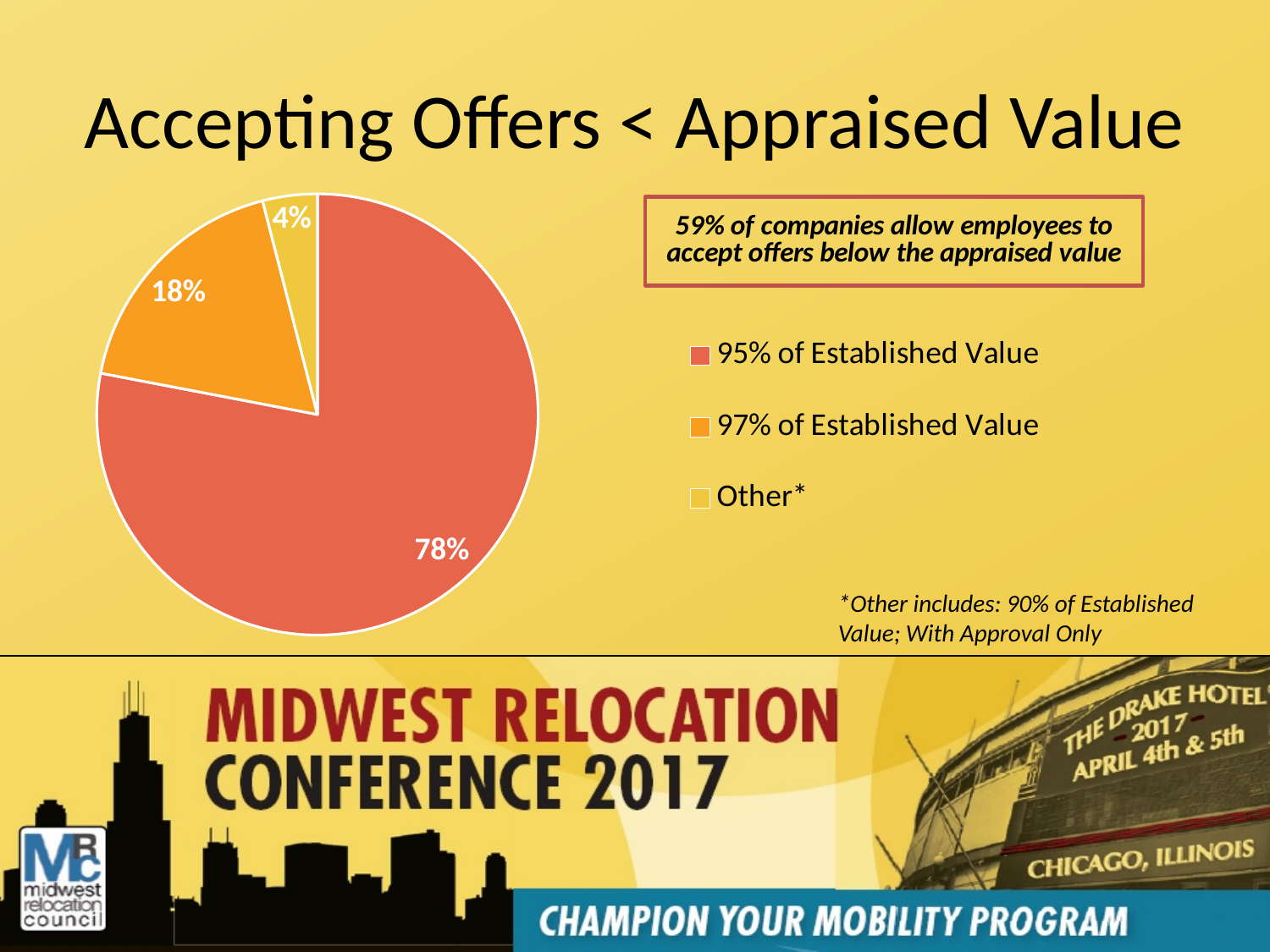
What kind of chart is shown on the slide? Pie chart Which category has the largest slice of the pie? 95% of Established Value How many slices does the pie chart have? 3 Which category has the smallest slice of the pie? Other* Which slice is larger: "97% of Established Value" or "Other*"? 97% of Established Value What share of the pie is labelled "Other*"? 4% What colour is the "95% of Established Value" slice? Red (coral) What share of the pie is labelled "97% of Established Value"? 18% What is the difference in percentage points between the "95% of Established Value" slice and the "97% of Established Value" slice? 60 percentage points How many entries does the legend list? 3 What share of the pie is labelled "95% of Established Value"? 78% What is the title of the slide containing the pie chart? Accepting Offers < Appraised Value